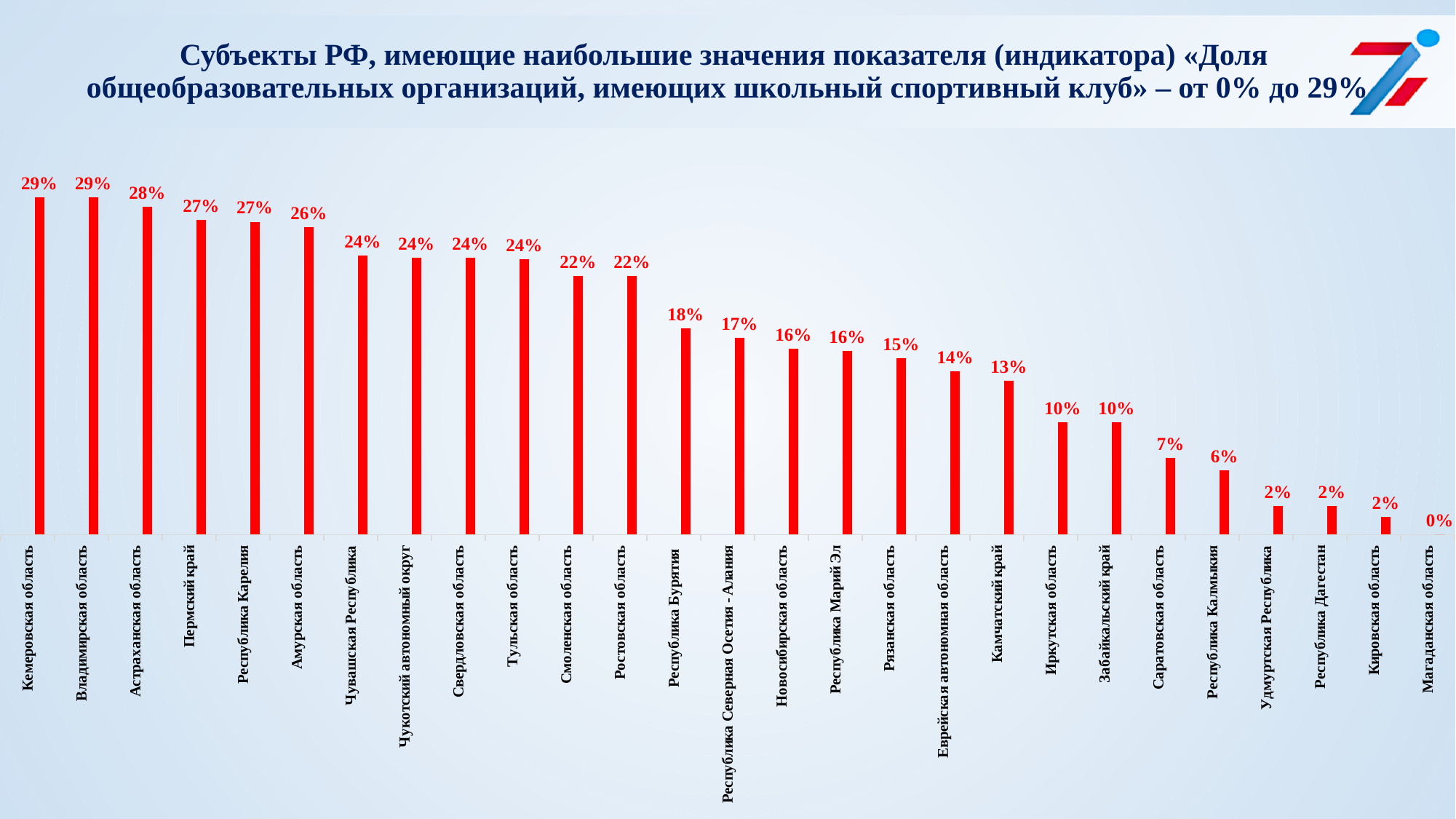
Do the values rise or fall from left to right along the x axis? Fall What is the value for Саратовская область? 7% Which is larger, the value for Иркутская область or the value for Рязанская область? Рязанская область What kind of chart is shown on the slide? Bar chart What is the value for Пермский край? 27% Which category has the lowest value? Магаданская область What is the value for Камчатский край? 13% Which is larger, the value for Амурская область or the value for Тульская область? Амурская область What is the value for Республика Бурятия? 18% What is the difference between the values for Новосибирская область and Республика Калмыкия? 10% How many categories are shown on the chart? 27 What is the difference between the values for Астраханская область and Ростовская область? 6%